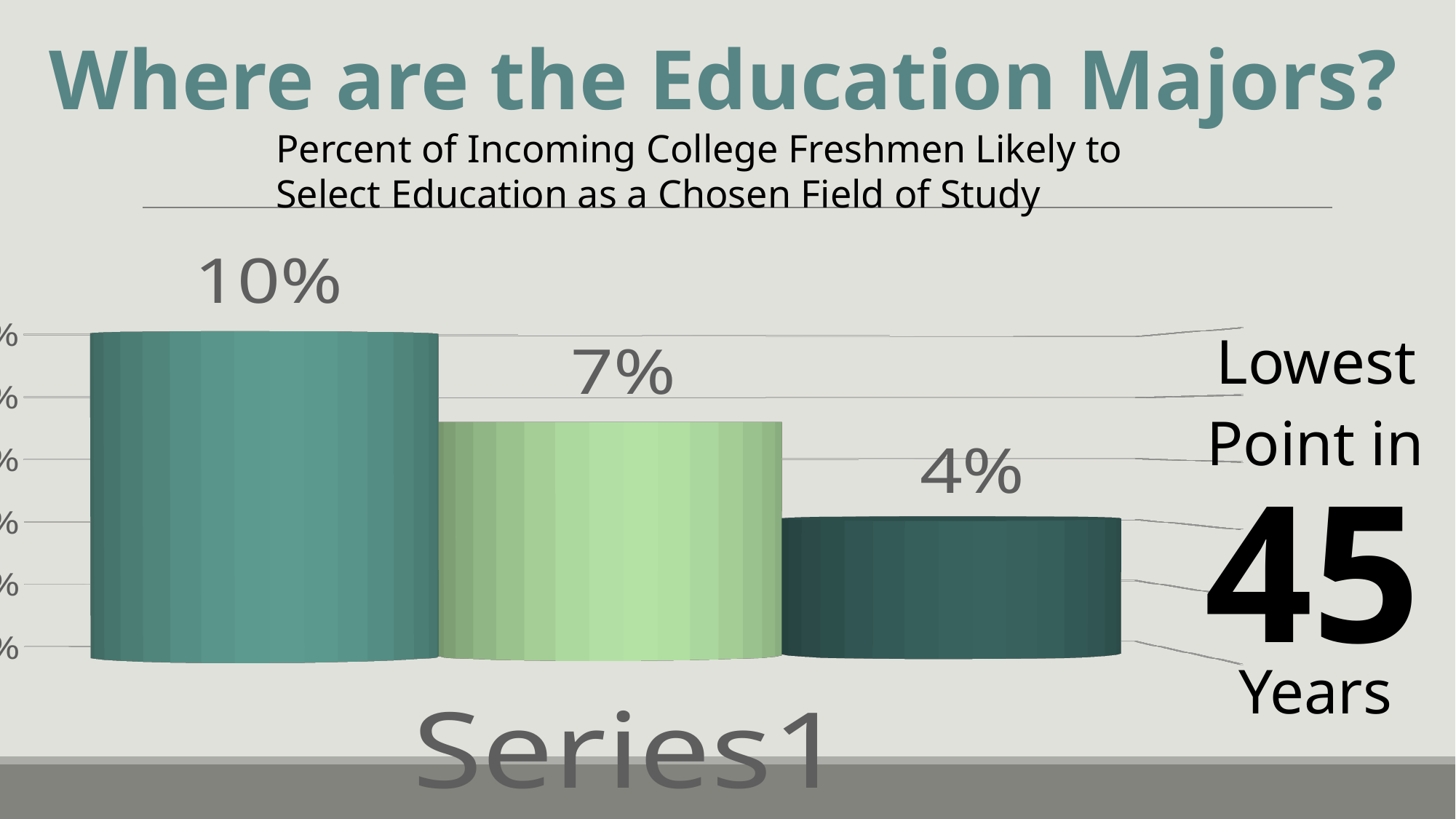
How many bars are plotted in the chart? 3 What value is shown on the rightmost bar of the chart? 4% What is the difference between the leftmost bar's value and the rightmost bar's value? 6% What value is shown on the leftmost bar of the chart? 10% Which is larger, the value of the middle bar or the value of the rightmost bar? the middle bar Which bar has the highest value: the leftmost, middle, or rightmost? leftmost Which bar has the lowest value: the leftmost, middle, or rightmost? rightmost Do the bar values rise or fall from left to right across the chart? fall What kind of chart is shown on the slide? bar chart What value is shown on the middle bar of the chart? 7% What is the difference between the middle bar's value and the rightmost bar's value? 3% What is the title of the slide? Where are the Education Majors?